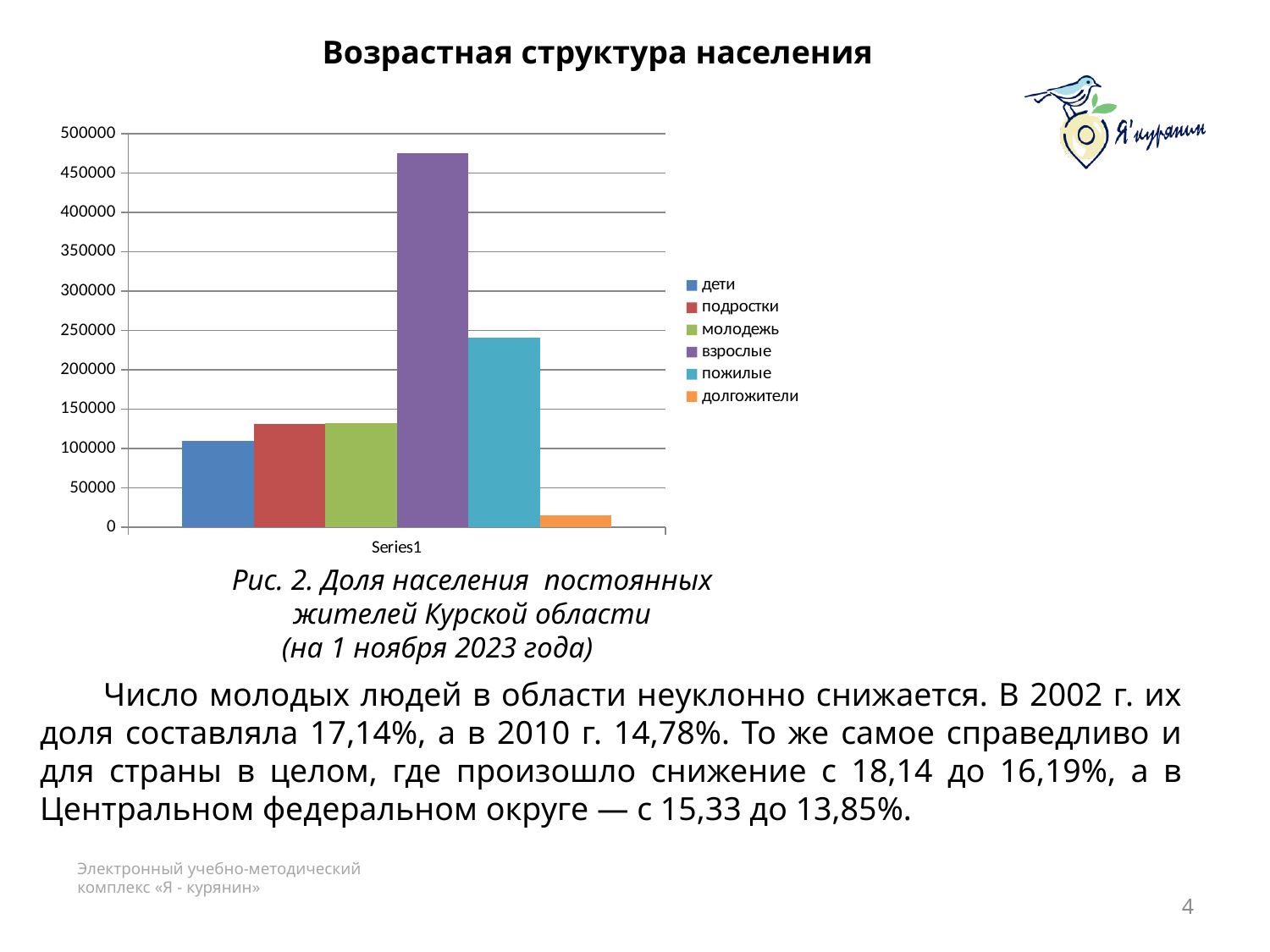
How many series does the chart legend list? 6 What kind of chart is shown on the slide? bar chart Which is larger, the value for взрослые or the value for пожилые? взрослые Which age group has the highest value in the chart? взрослые What is the title of the chart? Возрастная структура населения Which is larger, the value for дети or the value for пожилые? пожилые Is the value for взрослые greater or less than 450000? greater Is the value for долгожители greater or less than 50000? less Which legend entry is shown in purple? взрослые Is the value for дети greater or less than 100000? greater Which age group has the lowest value in the chart? долгожители